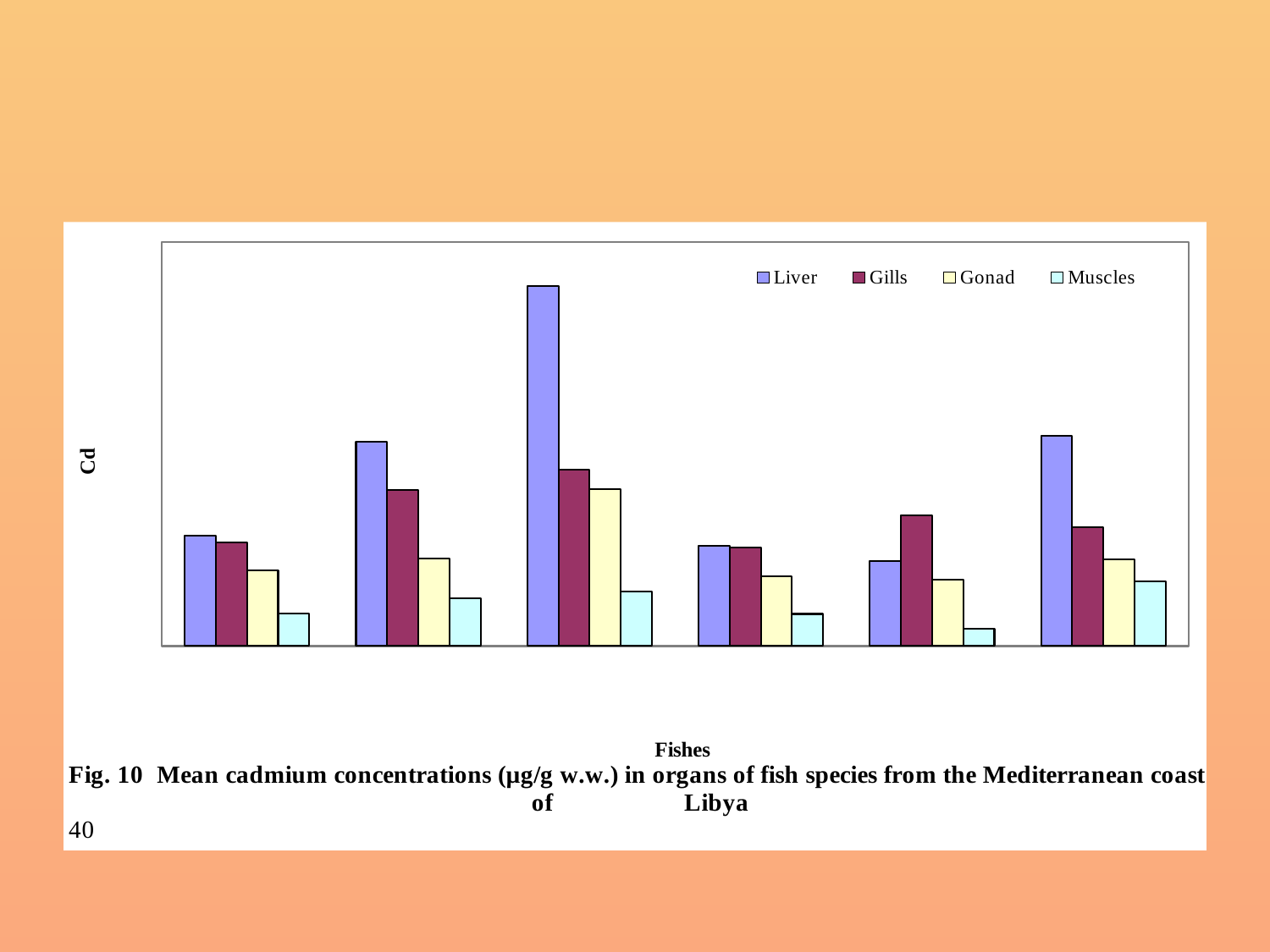
Which series has the tallest bar anywhere in the chart? Liver Which organs are listed in the chart's legend? Liver, Gills, Gonad, Muscles What kind of chart is shown on the slide? bar chart In the fifth group of bars from the left, which organ has the lowest value? Muscles In the second group of bars from the left, which is larger: the Liver value or the Gonad value? Liver In which group of bars, counting from the left, does the Liver bar reach its highest value? third In the sixth group of bars from the left, which organ has the highest value? Liver In the third group of bars from the left, which organ has the lowest value? Muscles How many series does the legend list? 4 What is the label on the vertical axis of the chart? Cd In the fifth group of bars from the left, which is larger: the Liver value or the Gills value? Gills How many groups of bars (fish species) are plotted along the x axis? 6